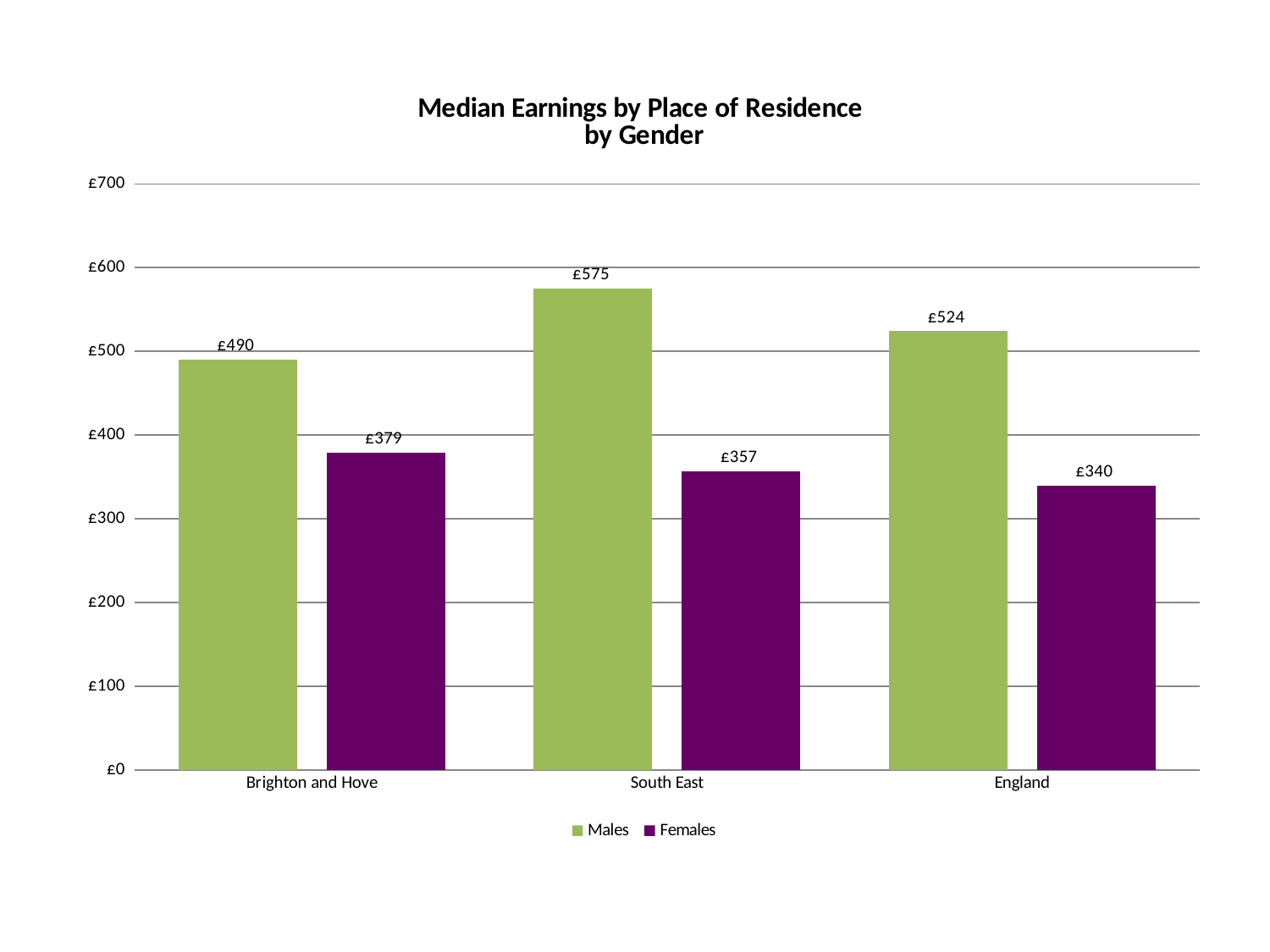
Is the value for Males in England greater or less than £500? greater What is the median earnings value for Males in Brighton and Hove? £490 Which place of residence has the lowest value for Females? England What is the median earnings value for Females in South East? £357 What is the median earnings value for Females in England? £340 Which is larger: the Females value for Brighton and Hove or the Females value for South East? Brighton and Hove Which place of residence has the highest value for Males? South East What kind of chart is shown on the slide? Bar chart What is the difference between the Males and Females values for South East? £218 How many series does the legend list? 2 How many places of residence are shown on the x axis? 3 What is the difference between the Males values for South East and England? £51